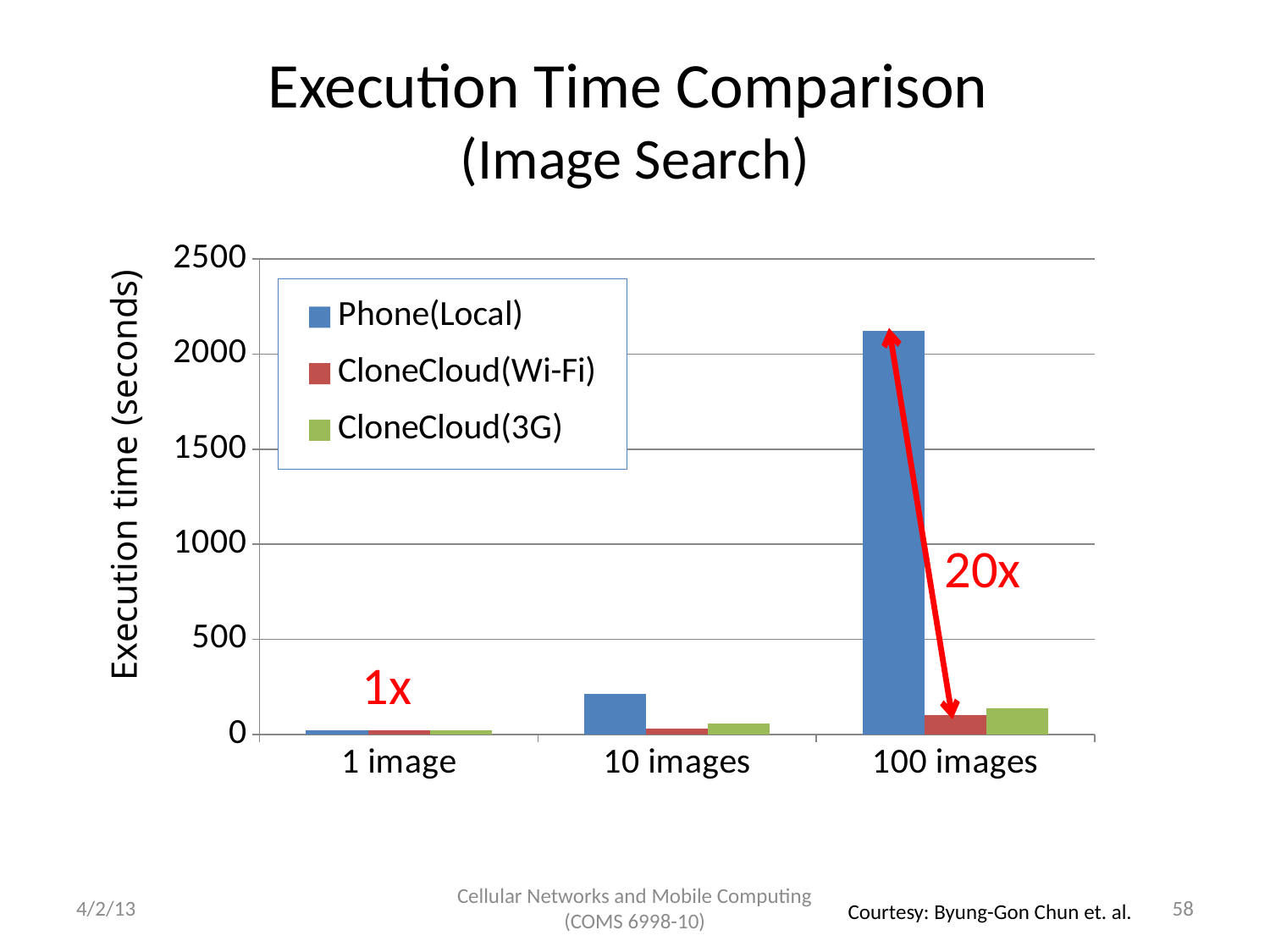
Which series has the lowest bar for 100 images? CloneCloud(Wi-Fi) What kind of chart is shown on the slide? bar chart Does the Phone(Local) execution time rise or fall as the number of images increases from 1 to 100? rise How many categories are shown on the x axis? 3 Is the value for Phone(Local) at 100 images greater or less than 2000? greater Which series has the highest bar for 100 images? Phone(Local) What is the label on the y axis of the chart? Execution time (seconds) Which is larger at 100 images: Phone(Local) or CloneCloud(Wi-Fi)? Phone(Local) Is the value for CloneCloud(3G) at 100 images greater or less than 500? less Is the value for Phone(Local) at 10 images greater or less than 500? less Which is larger at 10 images: CloneCloud(3G) or CloneCloud(Wi-Fi)? CloneCloud(3G) How many series does the legend list? 3